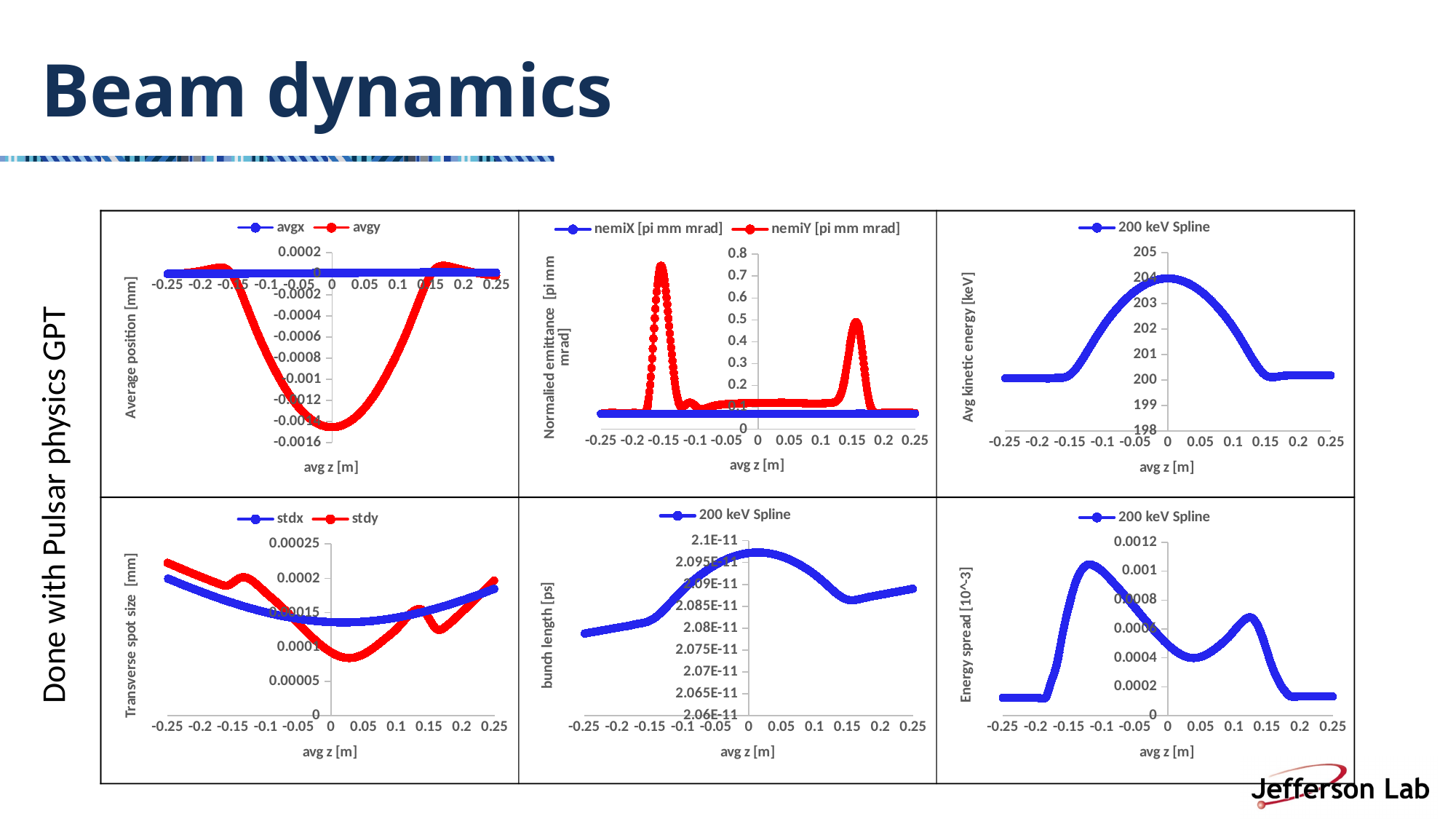
In the top-right chart (Avg kinetic energy), does the value rise or fall as avg z goes from -0.15 to 0? rise In the top-right chart (Avg kinetic energy), is the peak value greater or less than 203? greater In the top-left chart, what are the two legend entries? avgx and avgy What kind of chart is the bottom-right chart (Energy spread)? line chart In the top-middle chart, is the peak value of nemiY greater or less than 0.6? greater In the top-left chart, how many series does the legend list? 2 In the bottom-middle chart (bunch length), is the value at avg z = -0.25 greater or less than 2.085E-11? less In the bottom-left chart, at avg z = 0.05, which series has the larger value, stdx or stdy? stdx In the top-middle chart, which series reaches the higher peak, nemiX or nemiY? nemiY In the bottom-left chart, what are the two legend entries? stdx and stdy